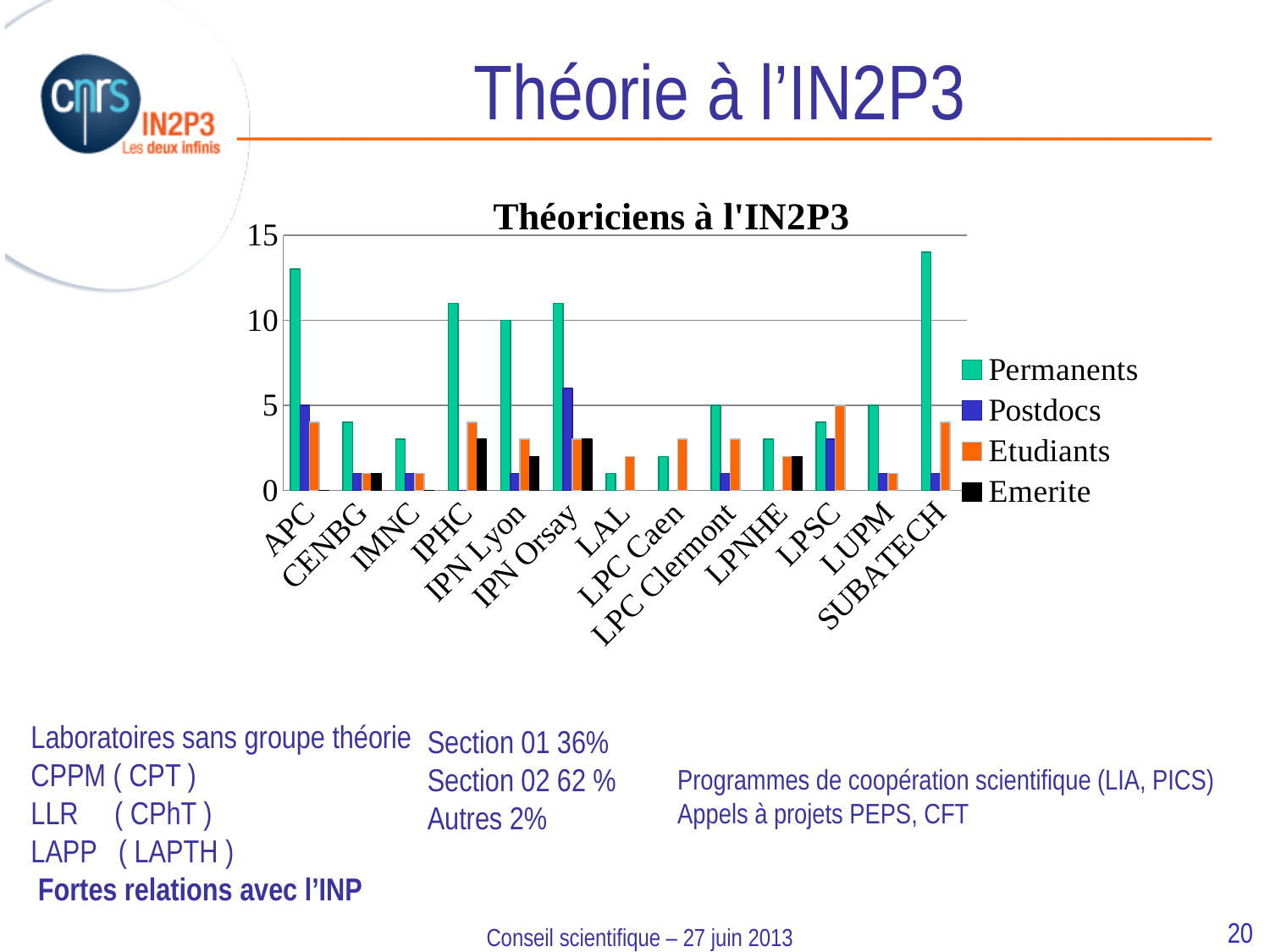
Is the Permanents value for APC greater or less than 10? greater Is the Permanents value for SUBATECH greater or less than 10? greater Is the Permanents value for LAL greater or less than 5? less Which has more Permanents, IPHC or LPNHE? IPHC Which series is shown in black in the chart legend? Emerite How many series does the legend of the chart list? 4 Which has more Postdocs, IPN Orsay or CENBG? IPN Orsay What kind of chart is shown on the slide? Bar chart Which laboratory has the highest Permanents value? SUBATECH What is the title of the chart? Théoriciens à l'IN2P3 How many laboratories are shown on the x axis of the chart? 13